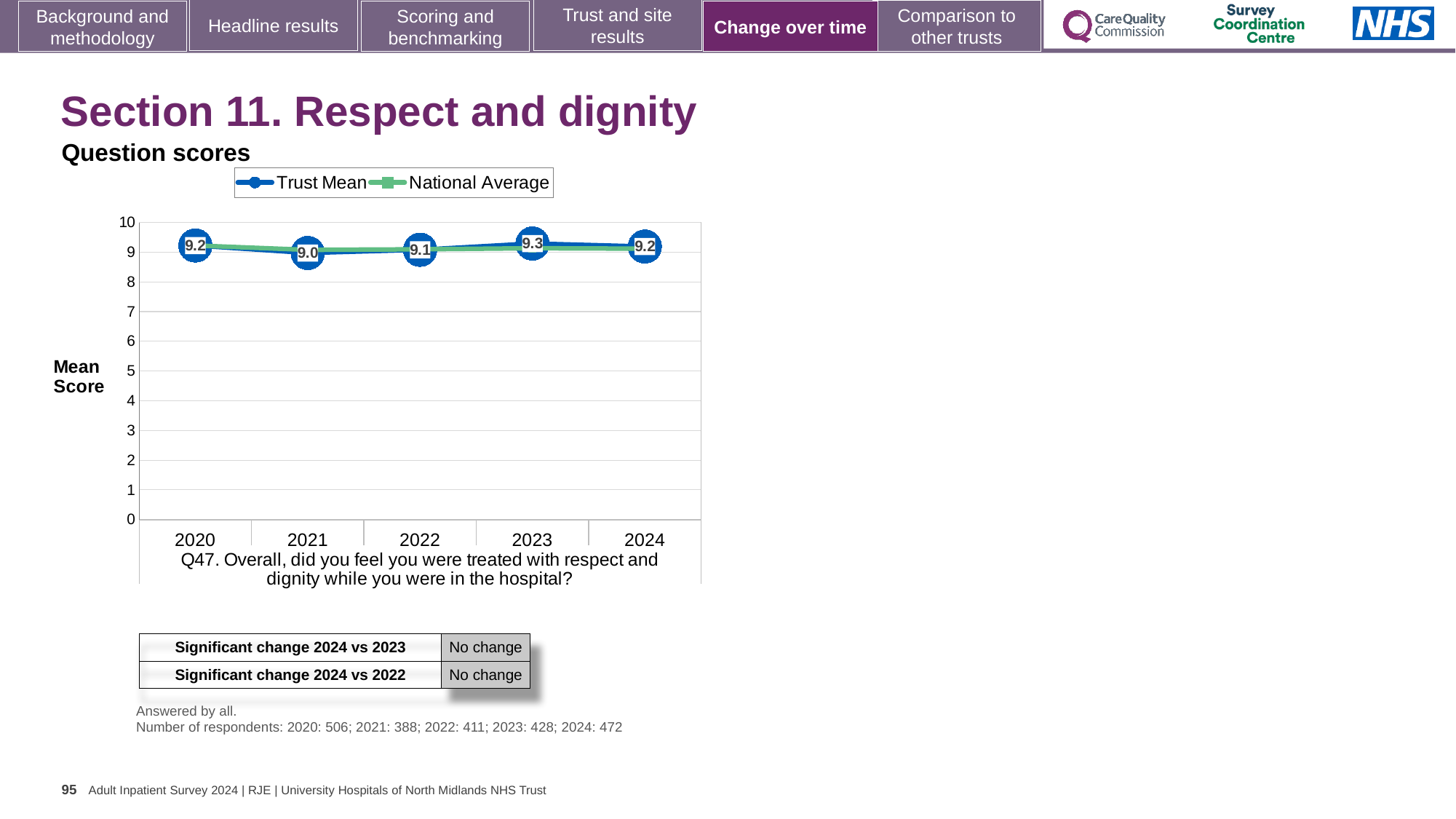
In which year is the Trust Mean score lowest? 2021 What is the Trust Mean score for 2021? 9.0 In which year is the Trust Mean score highest? 2023 What is the Trust Mean score for 2024? 9.2 How many years are shown on the x axis of the chart? 5 Which year has the larger Trust Mean score, 2020 or 2021? 2020 What is the Trust Mean score for 2023? 9.3 Is the Trust Mean score for 2022 greater or less than 8? greater What kind of chart is shown on the slide? Line chart What is the difference between the Trust Mean scores for 2023 and 2021? 0.3 How many series does the chart legend list? 2 What is the label of the y axis of the chart? Mean Score